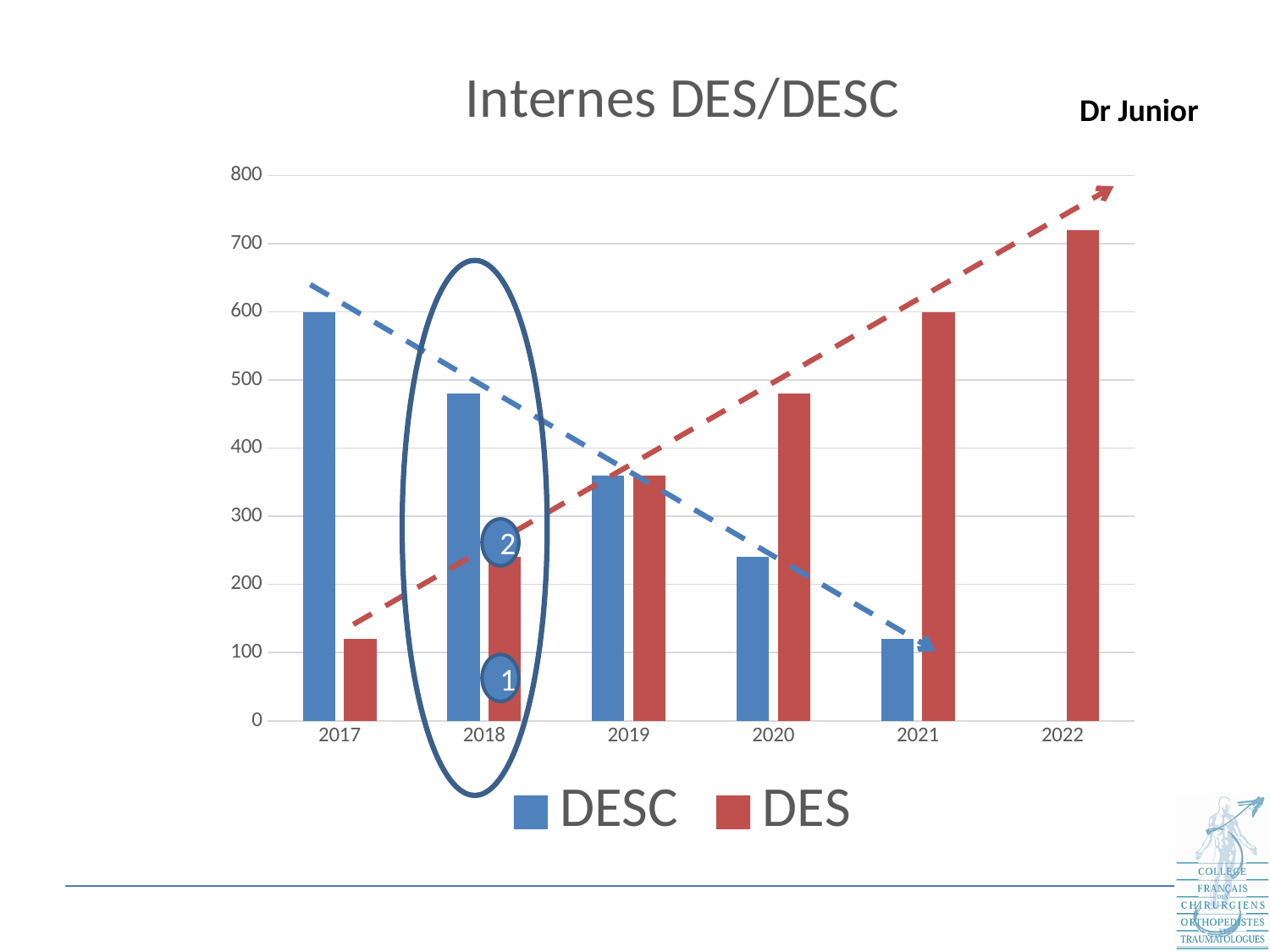
Is the DES value for 2022 greater or less than 700? greater What is the DES value for 2021? 600 Is the DES value for 2017 greater or less than 200? less Is the DESC value for 2021 greater or less than 200? less Do the DESC values rise or fall from 2017 to 2021? fall In 2020, which series has the larger value, DESC or DES? DES How many years are shown on the x axis? 6 How many series does the legend list? 2 Do the DES values rise or fall from 2017 to 2022? rise What kind of chart is shown on the slide? bar chart What is the DESC value for 2017? 600 What are the two series named in the legend? DESC and DES